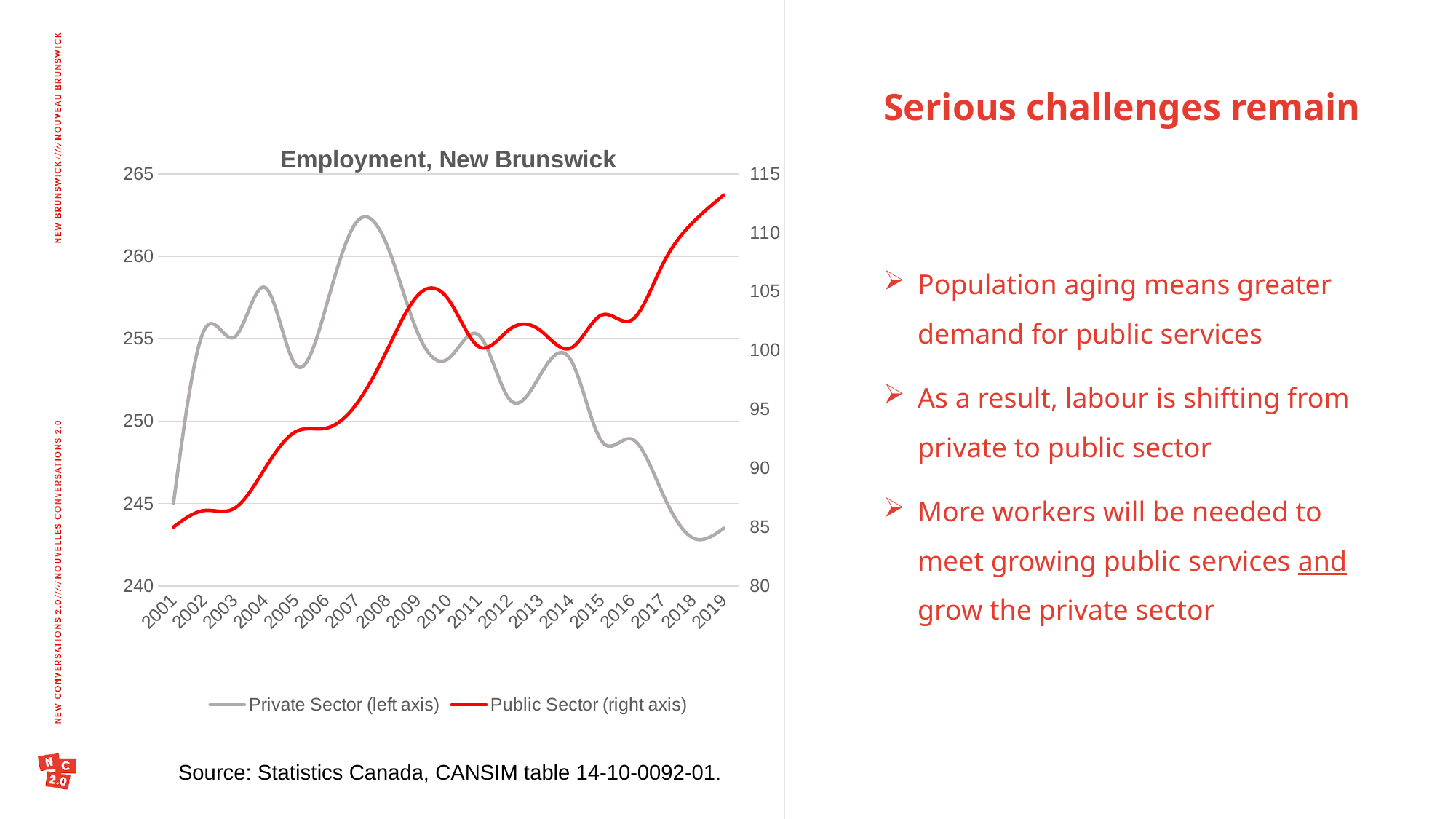
Is the Public Sector value for 2001 greater or less than 90? less How many series does the chart's legend list? 2 What is the title of the chart? Employment, New Brunswick In which year does the Public Sector series reach its highest value? 2019 What kind of chart is shown on the slide? Line chart Does the Public Sector series generally rise or fall from 2001 to 2019? Rise Is the Public Sector value for 2019 greater or less than 110? greater In which year does the Private Sector series reach its highest value? 2007 Which series is plotted against the right axis? Public Sector In which year is the Public Sector series at its lowest? 2001 Is the Private Sector value for 2007 greater or less than 260? greater How many years are shown on the x axis of the chart? 19